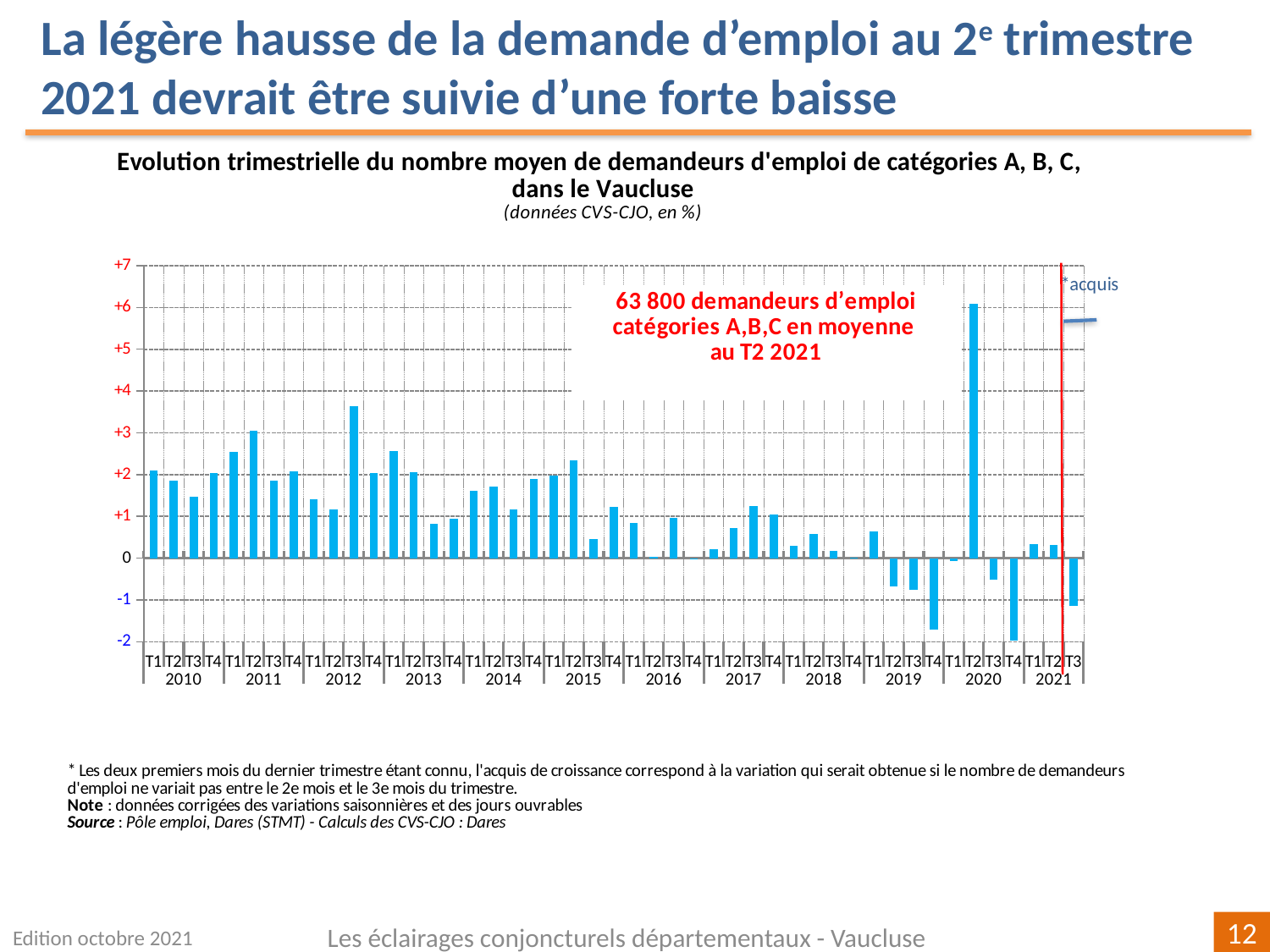
Is the value for T2 2021 greater or less than +1? less Which quarter has the highest value in the chart? T2 2020 What kind of chart is shown on the slide? Bar chart What does the red vertical line at the right of the chart mark? acquis Is the value for T3 2021 (acquis) greater or less than 0? less Is the value for T2 2020 greater or less than +5? greater How many years are labelled on the x axis of the chart? 12 According to the annotation on the chart, how many demandeurs d'emploi catégories A, B, C were there on average in T2 2021? 63 800 Which is larger, the value for T1 2019 or the value for T2 2019? T1 2019 Which is larger, the value for T2 2020 or the value for T3 2012? T2 2020